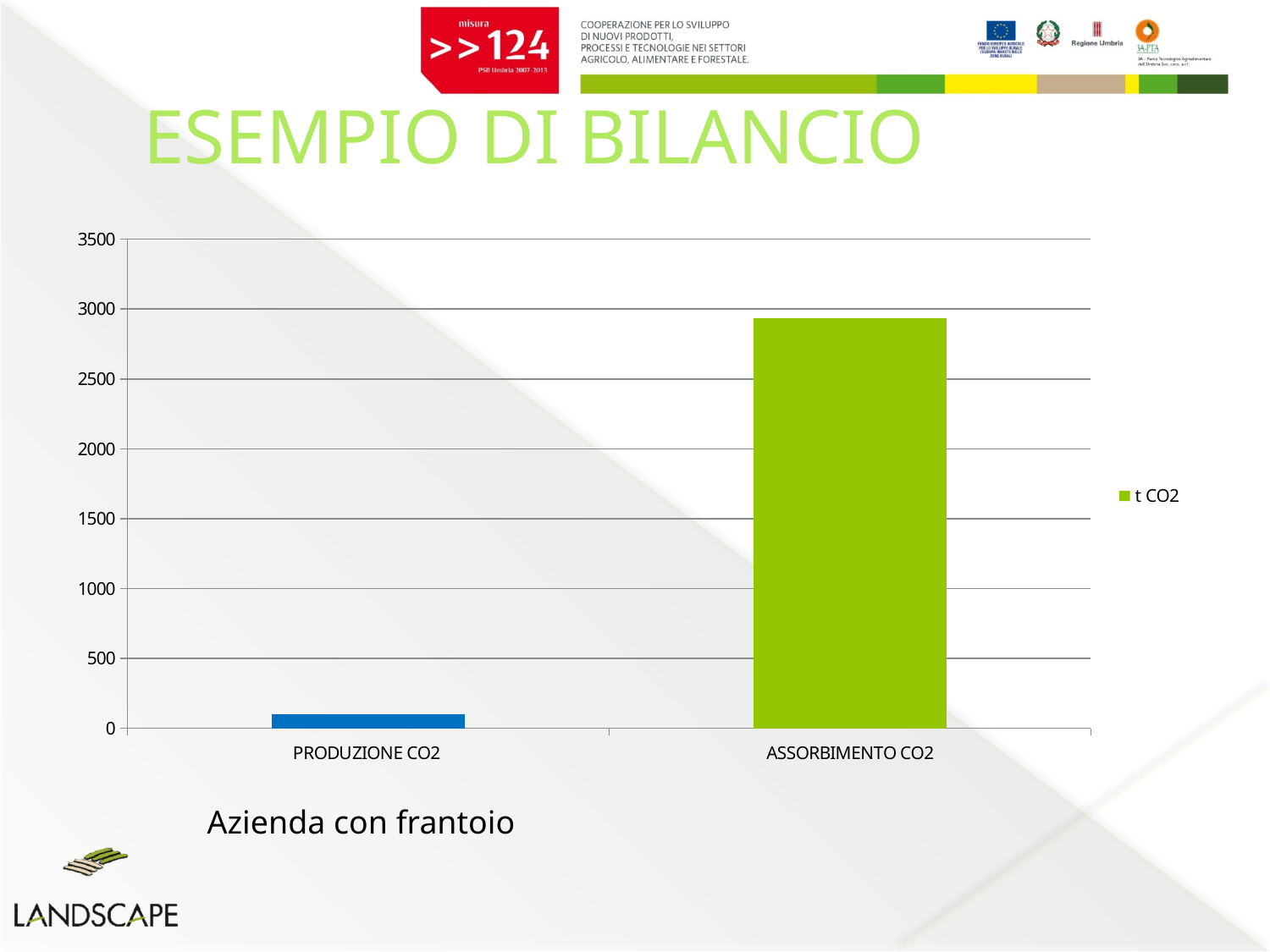
What is the maximum value shown on the chart's vertical axis? 3500 Which category has the highest value in the chart? ASSORBIMENTO CO2 How many series does the chart legend list? 1 What is the name of the series shown in the chart legend? t CO2 Which category has the lowest value in the chart? PRODUZIONE CO2 Is the value for ASSORBIMENTO CO2 greater or less than 2500? greater How many categories are plotted on the x axis of the chart? 2 Is the value for PRODUZIONE CO2 greater or less than 500? less Which is larger, the value for PRODUZIONE CO2 or the value for ASSORBIMENTO CO2? ASSORBIMENTO CO2 Is the value for ASSORBIMENTO CO2 greater or less than 3000? less What kind of chart is shown on the slide? bar chart